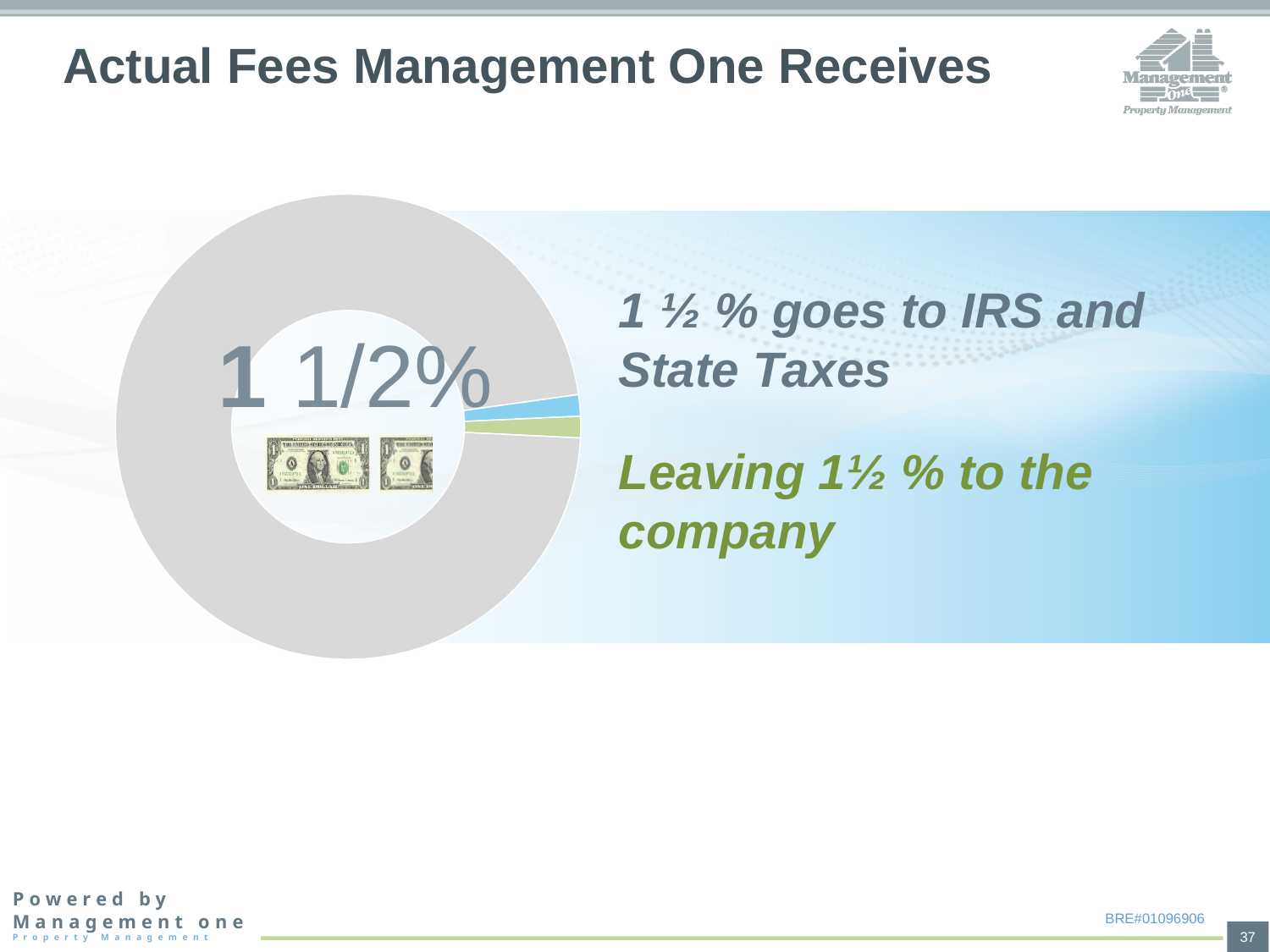
What is the title of the slide containing the donut chart? Actual Fees Management One Receives What colours are the two small slices of the donut chart? Blue and green What kind of chart is shown on the slide? Pie (donut) chart Is the gray slice or the blue slice of the donut chart larger? The gray slice Which slice of the donut chart is the largest? The gray slice What percentage is printed in the centre of the donut chart? 1 1/2% How many slices does the donut chart have? 3